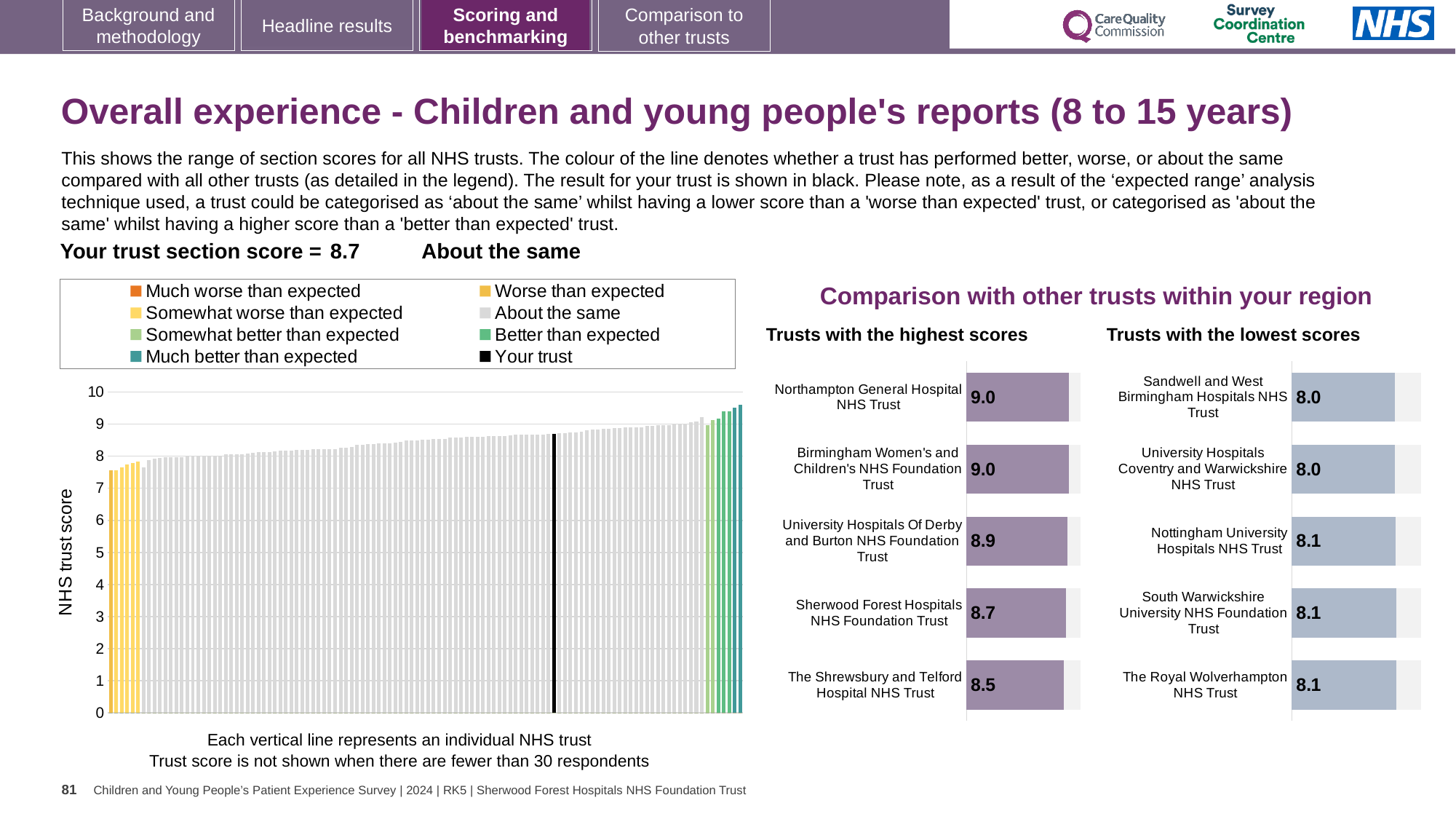
How many entries does the legend above the large chart on the left list? 8 How many trusts are shown in the 'Trusts with the lowest scores' chart? 5 In the large chart on the left, is the value of the leftmost (lowest) bar greater or less than 8? less In the 'Trusts with the highest scores' chart, which trust has the lowest score? The Shrewsbury and Telford Hospital NHS Trust What kind of chart is the large chart on the left showing NHS trust scores? bar chart In the 'Trusts with the highest scores' chart, what is the difference between the scores of Northampton General Hospital NHS Trust and The Shrewsbury and Telford Hospital NHS Trust? 0.5 In the 'Trusts with the highest scores' chart, what is the score for University Hospitals Of Derby and Burton NHS Foundation Trust? 8.9 What is the section score for your trust shown on the slide? 8.7 In the large chart on the left, is the value of the rightmost (highest) bar greater or less than 9? greater In the 'Trusts with the lowest scores' chart, what is the score for Nottingham University Hospitals NHS Trust? 8.1 Which is larger: the score for Sherwood Forest Hospitals NHS Foundation Trust in the 'Trusts with the highest scores' chart or the score for The Royal Wolverhampton NHS Trust in the 'Trusts with the lowest scores' chart? Sherwood Forest Hospitals NHS Foundation Trust In the large chart on the left, do the trust scores rise or fall from left to right? rise